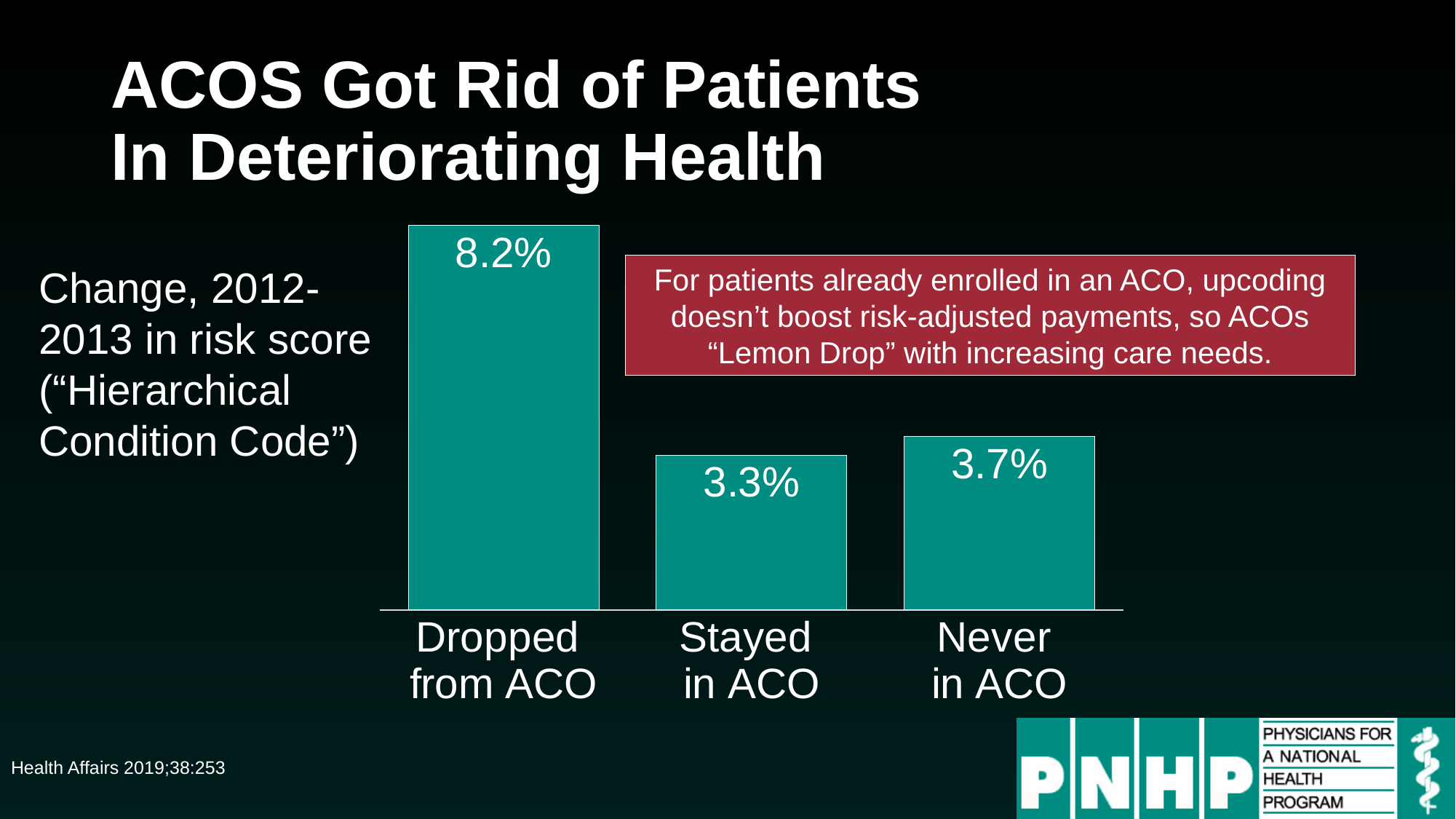
What is the difference between the change in risk score for patients dropped from ACO and those who stayed in ACO? 4.9% What is the change in risk score for patients dropped from ACO? 8.2% What time period does the chart's change in risk score cover? 2012-2013 What is the change in risk score for patients never in ACO? 3.7% What kind of chart is shown on the slide? Bar chart What is the difference between the change in risk score for patients never in ACO and those who stayed in ACO? 0.4% What is the change in risk score for patients who stayed in ACO? 3.3% How many categories are shown in the chart? 3 Which category has the highest change in risk score? Dropped from ACO Which is larger: the change in risk score for patients dropped from ACO or for patients never in ACO? Dropped from ACO What colour are the bars in the chart? Teal Which category has the lowest change in risk score? Stayed in ACO